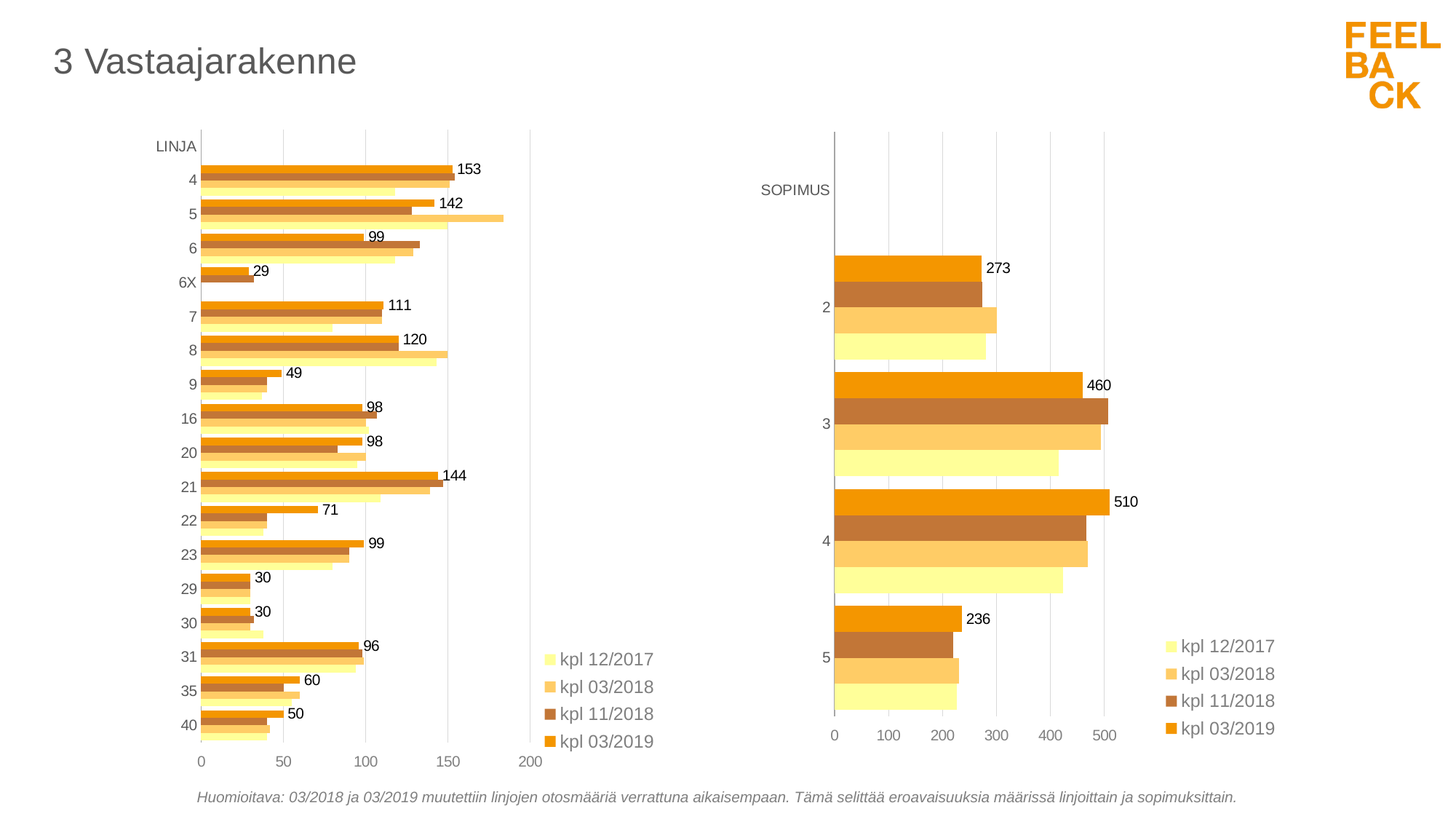
In the SOPIMUS chart on the right, what is the difference between the kpl 03/2019 values for sopimus 4 and sopimus 3? 50 In the SOPIMUS chart on the right, what is the kpl 03/2019 value for sopimus 4? 510 In the LINJA chart on the left, what is the kpl 03/2019 value for linja 21? 144 In the SOPIMUS chart on the right, which sopimus has the highest kpl 03/2019 value? 4 What kind of chart is the LINJA chart on the left? bar chart In the LINJA chart on the left, which linja has the lowest kpl 03/2019 value? 6X In the LINJA chart on the left, for linja 5, which is larger: the kpl 03/2018 value or the kpl 03/2019 value? kpl 03/2018 In the SOPIMUS chart on the right, which sopimus has the lowest kpl 03/2019 value? 5 In the LINJA chart on the left, which linja has the highest kpl 03/2019 value? 4 How many series does the legend of the SOPIMUS chart on the right list? 4 How many sopimus categories are shown in the SOPIMUS chart on the right? 4 In the LINJA chart on the left, what is the difference between the kpl 03/2019 values for linja 4 and linja 5? 11